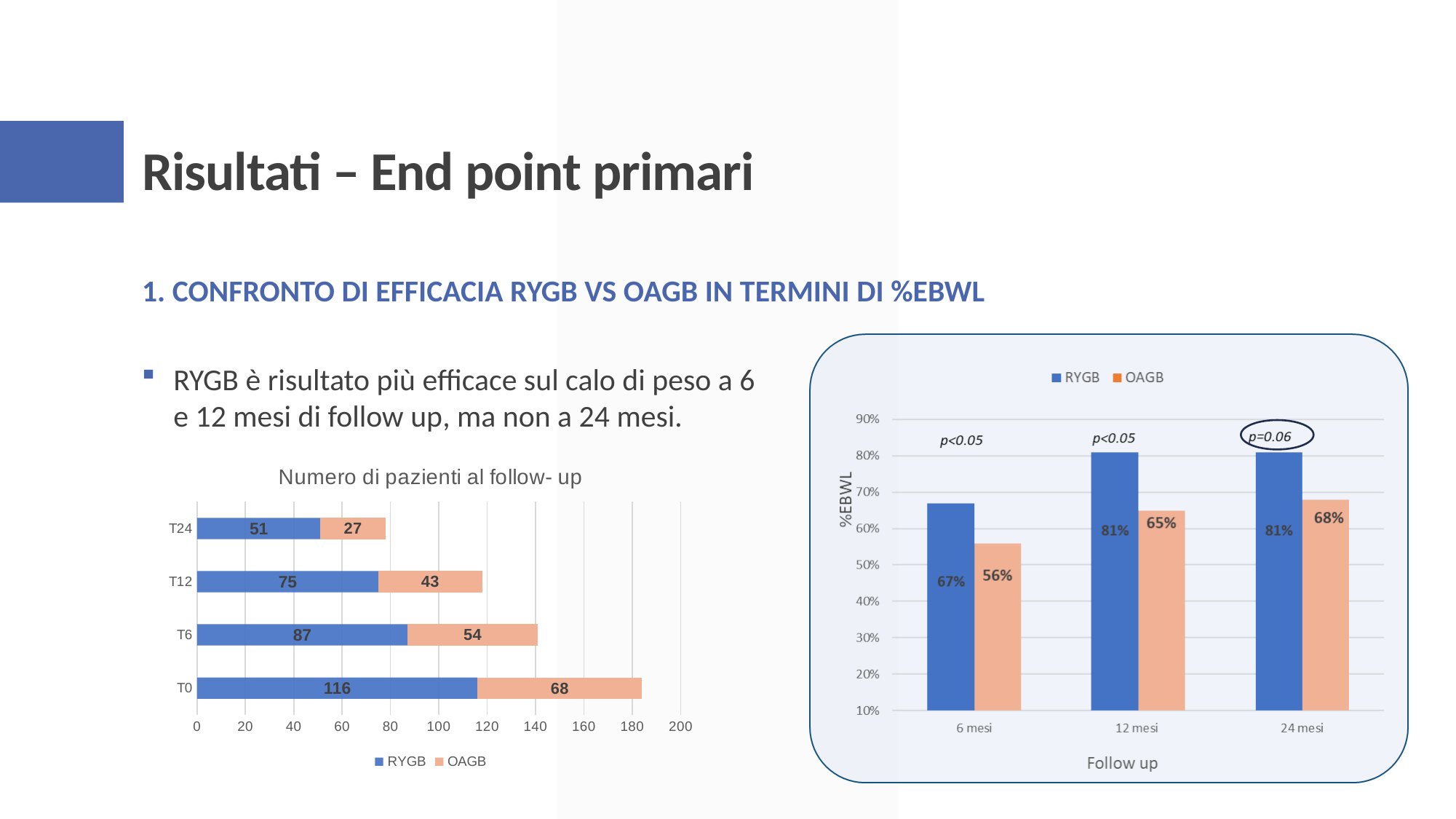
In the 'Numero di pazienti al follow- up' chart, what is the RYGB value at T0? 116 What kind of chart is the 'Numero di pazienti al follow- up' chart? Stacked bar chart In the %EBWL chart on the right, what is the OAGB value at 6 mesi? 56% In the 'Numero di pazienti al follow- up' chart, what is the difference between the RYGB and OAGB values at T24? 24 In the %EBWL chart on the right, how many series does the legend list? 2 In the %EBWL chart on the right, does the OAGB value rise or fall from 6 mesi to 24 mesi? Rise In the 'Numero di pazienti al follow- up' chart, which time point has the lowest RYGB value? T24 In the 'Numero di pazienti al follow- up' chart, how many time-point categories are shown? 4 In the %EBWL chart on the right, what is the RYGB value at 12 mesi? 81% In the 'Numero di pazienti al follow- up' chart, what is the OAGB value at T12? 43 In the %EBWL chart on the right, what is the difference between RYGB and OAGB at 24 mesi? 13% In the 'Numero di pazienti al follow- up' chart, what is the total of the stacked bar for T6? 141